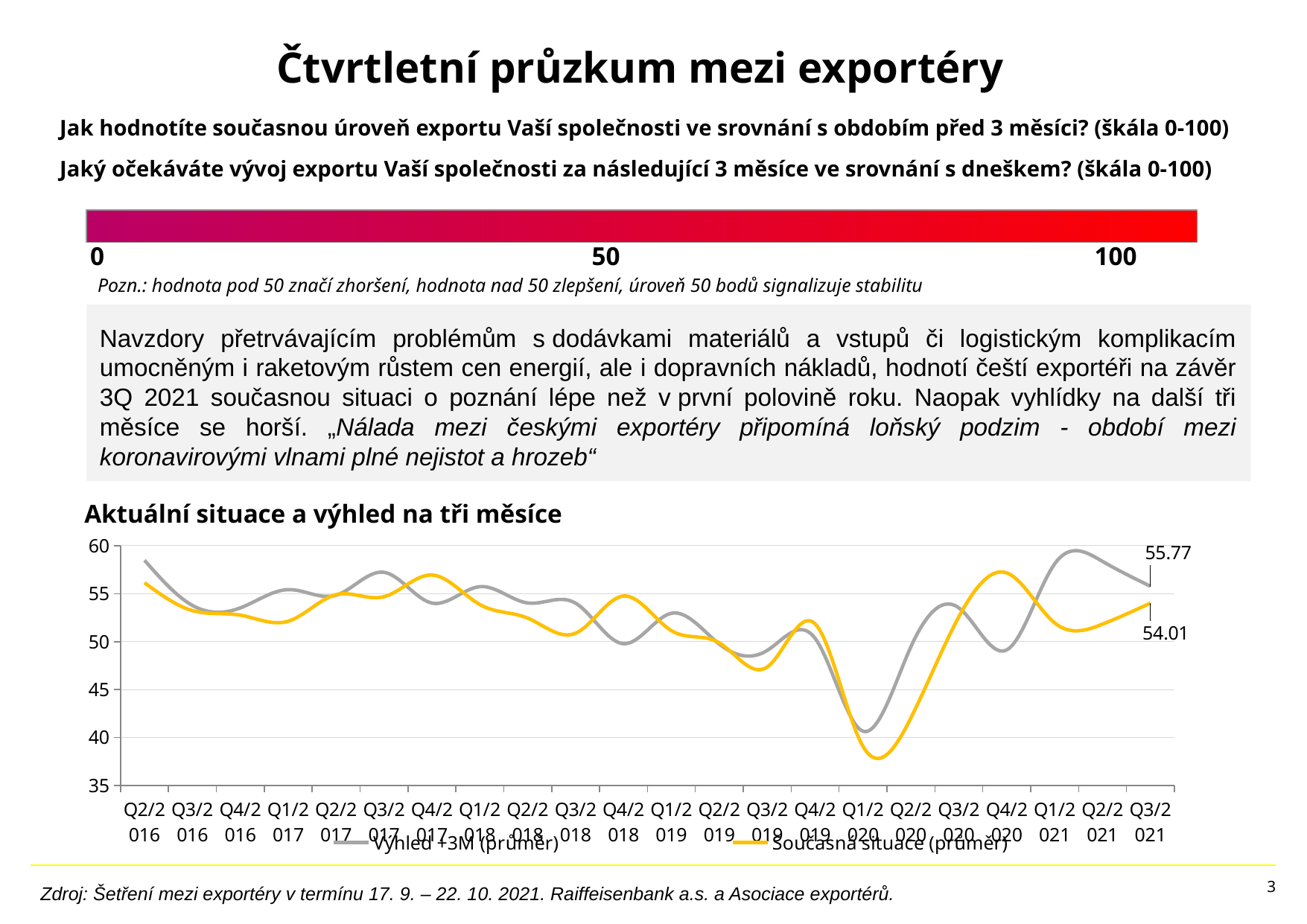
Is the value of Současná situace (průměr) for Q1/2020 greater or less than 40? less What is the difference between Výhled +3M (průměr) and Současná situace (průměr) in Q3/2021? 1.76 In which quarter does Současná situace (průměr) reach its lowest value? Q1/2020 What is the value of Výhled +3M (průměr) for Q3/2021? 55.77 In Q3/2021, which series has the higher value: Výhled +3M (průměr) or Současná situace (průměr)? Výhled +3M (průměr) Is the value of Výhled +3M (průměr) for Q2/2021 greater or less than 55? greater How many quarters are shown on the x axis of the chart? 22 Is the value of Současná situace (průměr) for Q3/2019 greater or less than 50? less In which quarter does Výhled +3M (průměr) reach its lowest value? Q1/2020 How many series does the chart legend list? 2 What is the value of Současná situace (průměr) for Q3/2021? 54.01 What type of chart is shown on the slide? Line chart